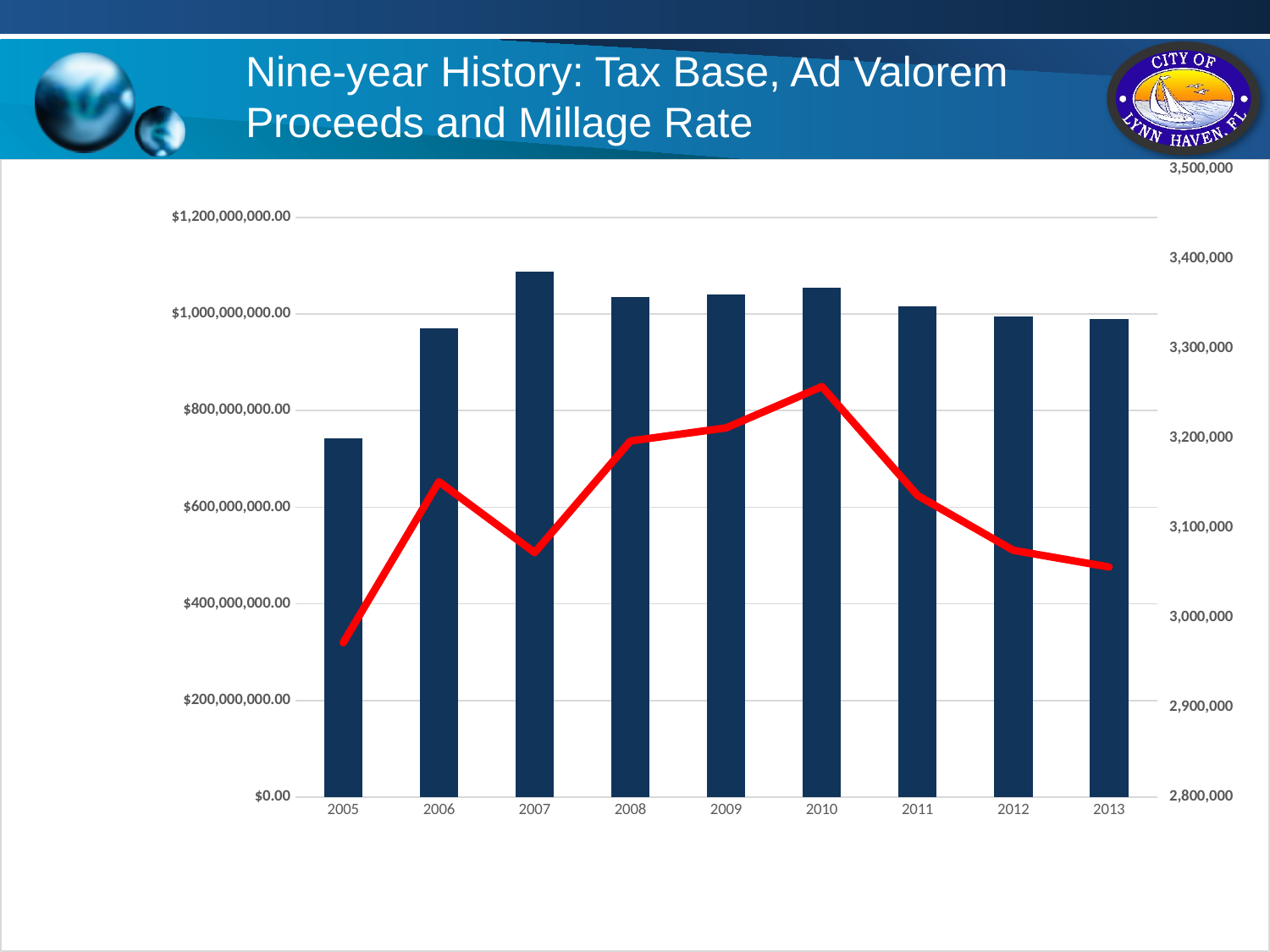
Is the bar value for 2005 greater or less than $800,000,000.00? less Which year has a taller bar, 2007 or 2010? 2007 In which year does the red line reach its highest point? 2010 Which year has the tallest bar in the chart? 2007 Does the red line rise or fall from 2010 to 2013? fall Is the bar value for 2007 greater or less than $1,000,000,000.00? greater Is the red line value for 2005 greater or less than 3,000,000 on the right axis? less Which year has the shortest bar in the chart? 2005 Which year has a taller bar, 2006 or 2011? 2011 How many years are shown on the x axis of the chart? 9 In which year is the red line at its lowest point? 2005